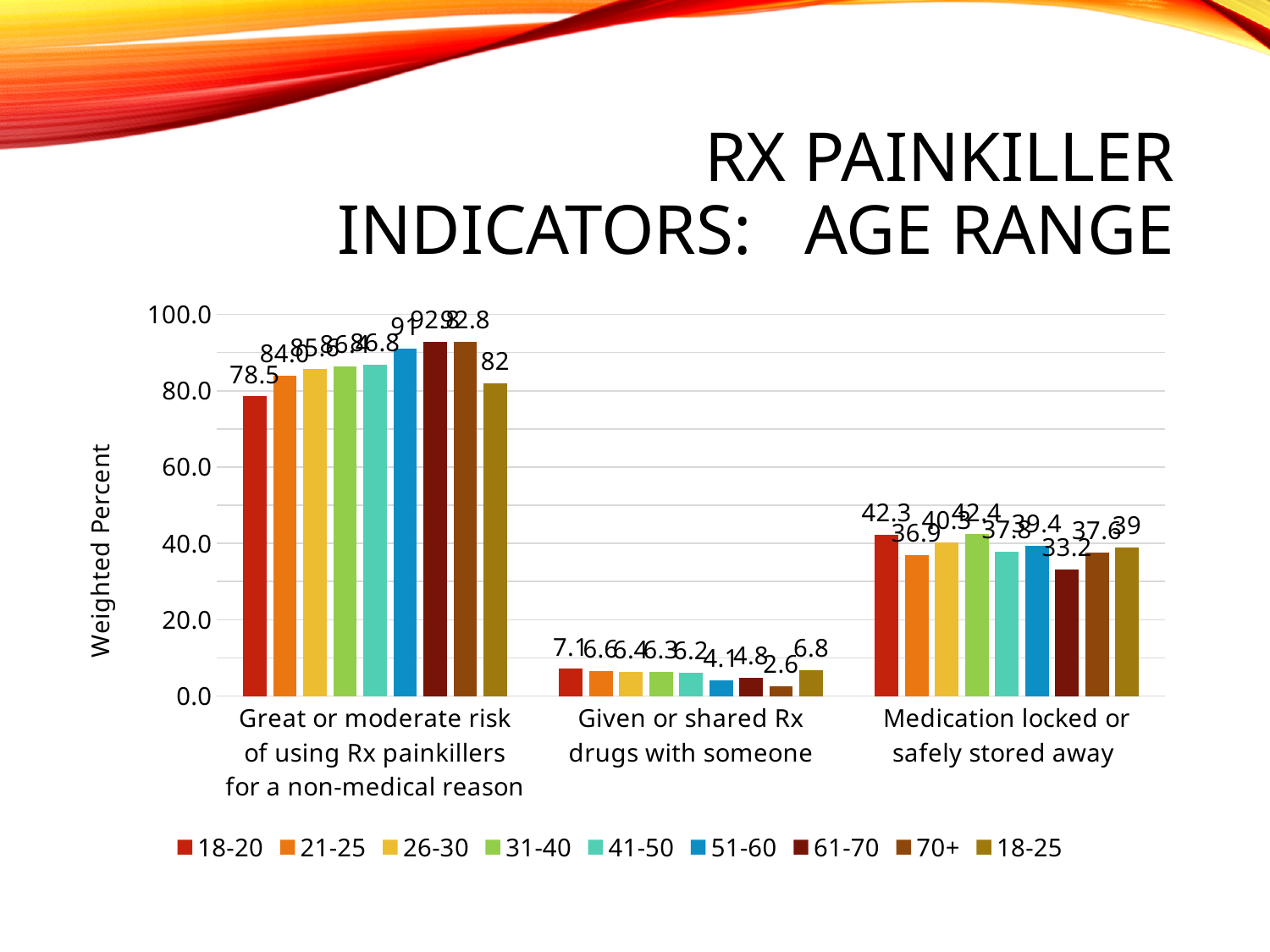
What is the value for the 61-70 age group in the 'Medication locked or safely stored away' category? 33.2 How many categories are shown on the x axis? 3 What is the value for the 18-20 age group in the 'Great or moderate risk of using Rx painkillers for a non-medical reason' category? 78.5 How many age groups does the legend list? 9 What is the value for the 18-25 age group in the 'Great or moderate risk of using Rx painkillers for a non-medical reason' category? 82 In the 'Great or moderate risk of using Rx painkillers for a non-medical reason' category, what is the difference between the 18-25 value and the 18-20 value? 3.5 What is the title of the y axis? Weighted Percent What is the value for the 70+ age group in the 'Given or shared Rx drugs with someone' category? 2.6 Which age group has the lowest value in the 'Medication locked or safely stored away' category? 61-70 In the 'Great or moderate risk of using Rx painkillers for a non-medical reason' category, which is larger: the 18-20 value or the 18-25 value? 18-25 Which age group has the lowest value in the 'Given or shared Rx drugs with someone' category? 70+ What is the value for the 18-20 age group in the 'Medication locked or safely stored away' category? 42.3